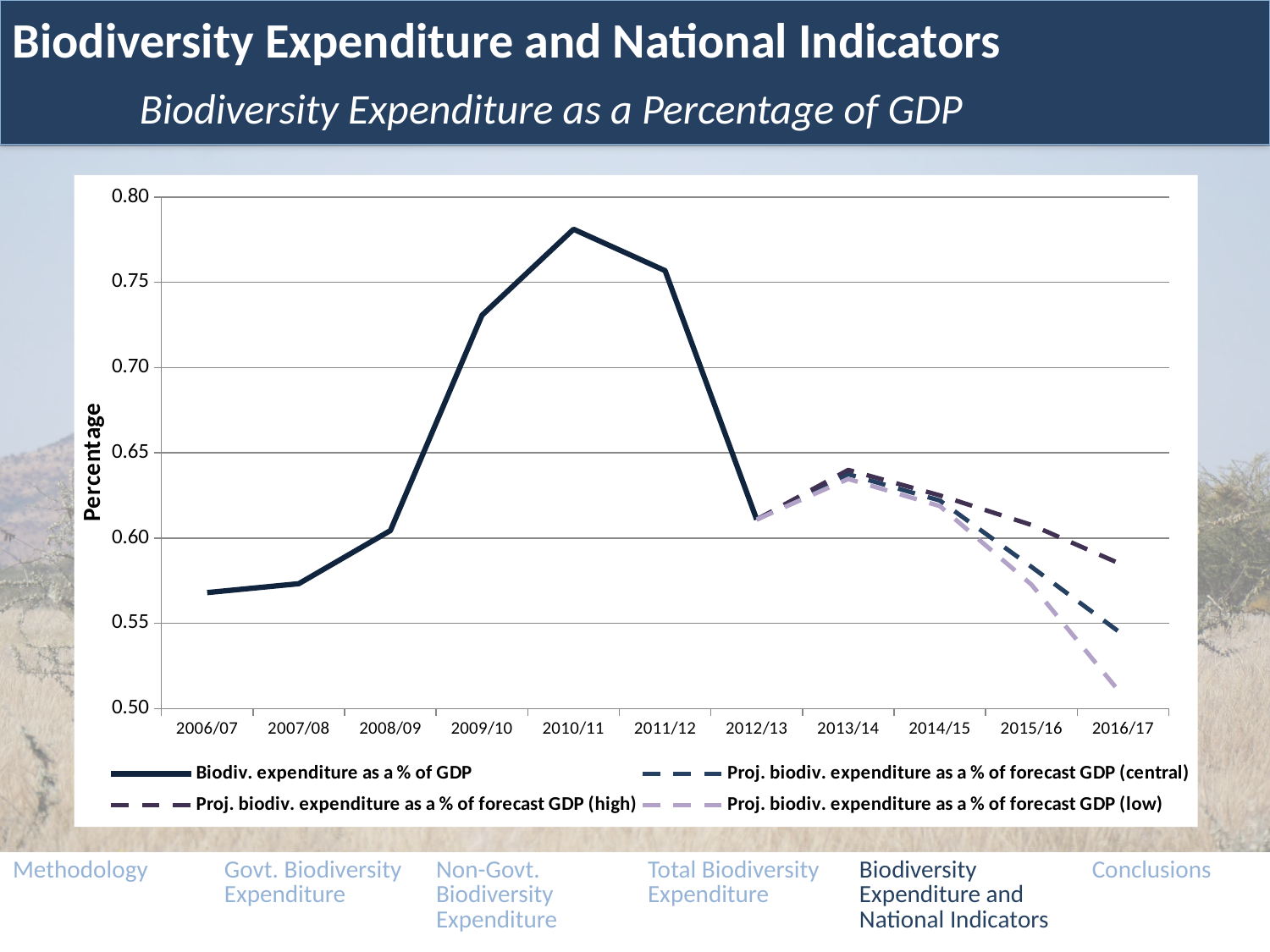
Is the value of 'Biodiv. expenditure as a % of GDP' for 2006/07 greater or less than 0.60? less Is the value of 'Proj. biodiv. expenditure as a % of forecast GDP (low)' for 2016/17 greater or less than 0.55? less In which year does the solid 'Biodiv. expenditure as a % of GDP' line reach its highest value? 2010/11 Which is larger for 'Biodiv. expenditure as a % of GDP': the value for 2010/11 or the value for 2011/12? 2010/11 Does the solid 'Biodiv. expenditure as a % of GDP' line rise or fall from 2006/07 to 2010/11? Rise What kind of chart is shown on the slide? Line chart In which year is the solid 'Biodiv. expenditure as a % of GDP' line at its lowest value? 2006/07 How many series does the legend list? 4 Is the value of 'Biodiv. expenditure as a % of GDP' for 2010/11 greater or less than 0.75? greater What is the label on the y axis? Percentage At 2016/17, which projection is higher: the high forecast or the low forecast? High forecast How many fiscal years are shown on the x axis? 11